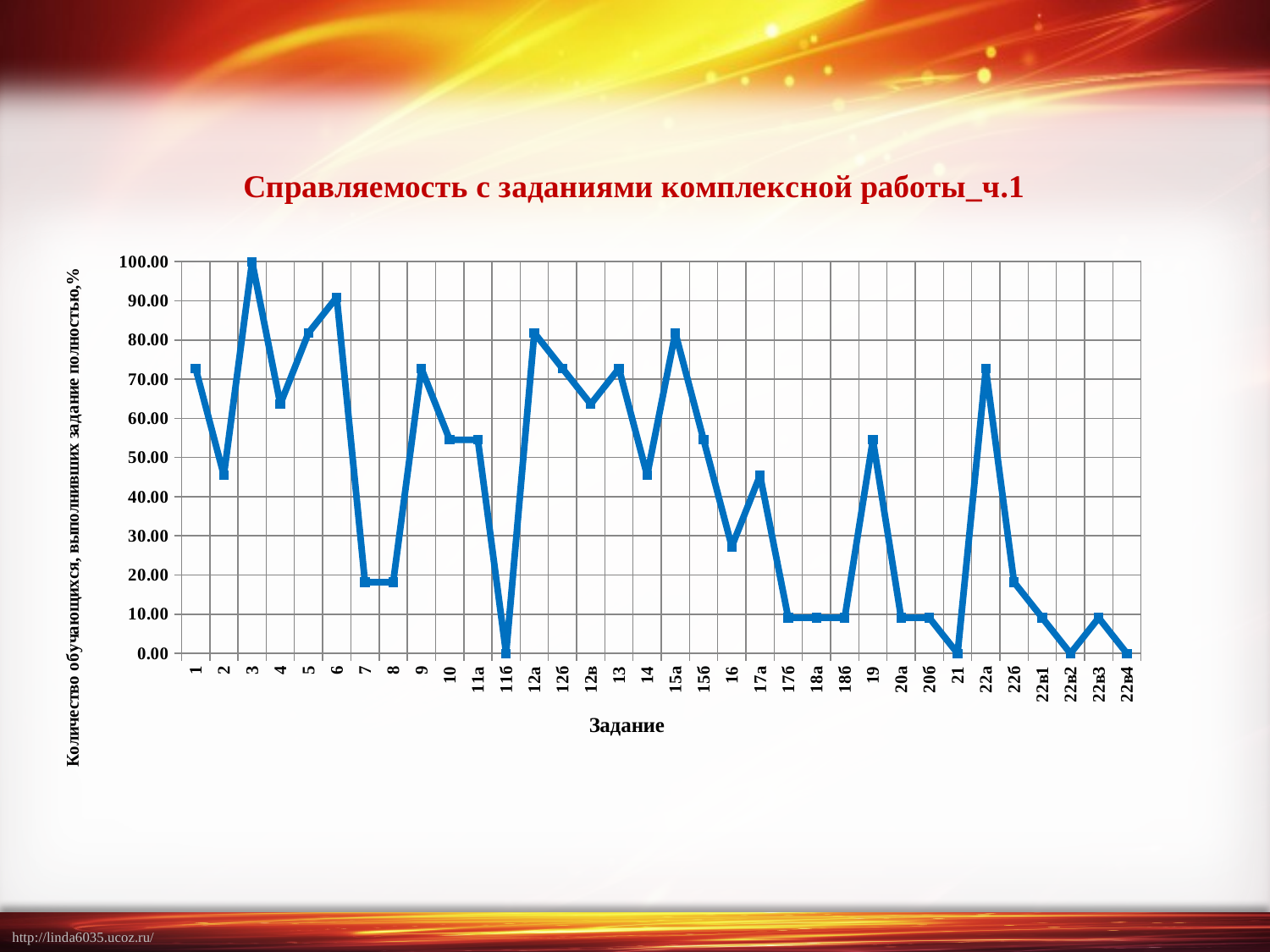
From task 22а to task 22в2, do the values rise or fall? fall What is the title of the chart? Справляемость с заданиями комплексной работы_ч.1 Which is larger, the value for task 22а or the value for task 22б? 22а Which task has the highest value? 3 What is the label of the x axis? Задание What is the value for task 3? 100.00 What kind of chart is shown on the slide? line chart How many tasks (categories) are plotted on the x axis? 34 What is the value for task 11б? 0.00 What is the value for task 21? 0.00 Is the value for task 6 greater or less than 80.00? greater Is the value for task 16 greater or less than 40.00? less